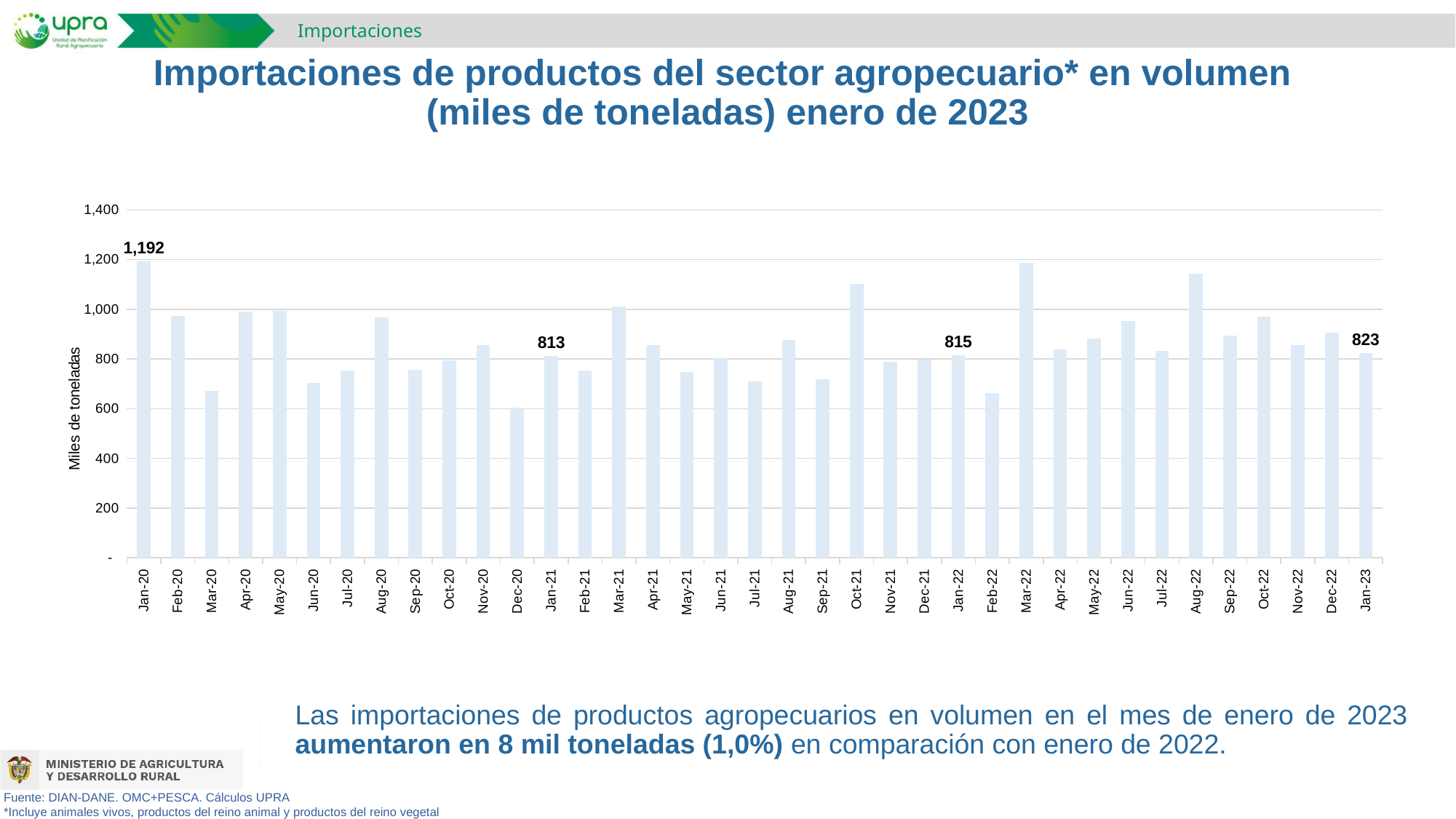
What is the value for Jan-20? 1,192 What is the difference between the values for Jan-20 and Jan-21? 379 Is the value for Jun-20 greater or less than 800? less What is the value for Jan-22? 815 What is the value for Jan-23? 823 What is the difference between the values for Jan-23 and Jan-22? 8 What is the value for Jan-21? 813 Is the value for Oct-21 greater or less than 1,000? greater What kind of chart is shown on the slide? bar chart Which is larger, the value for Jan-23 or the value for Jan-22? Jan-23 How many monthly bars are plotted in the chart? 37 Which month has the lowest value in the chart? Dec-20